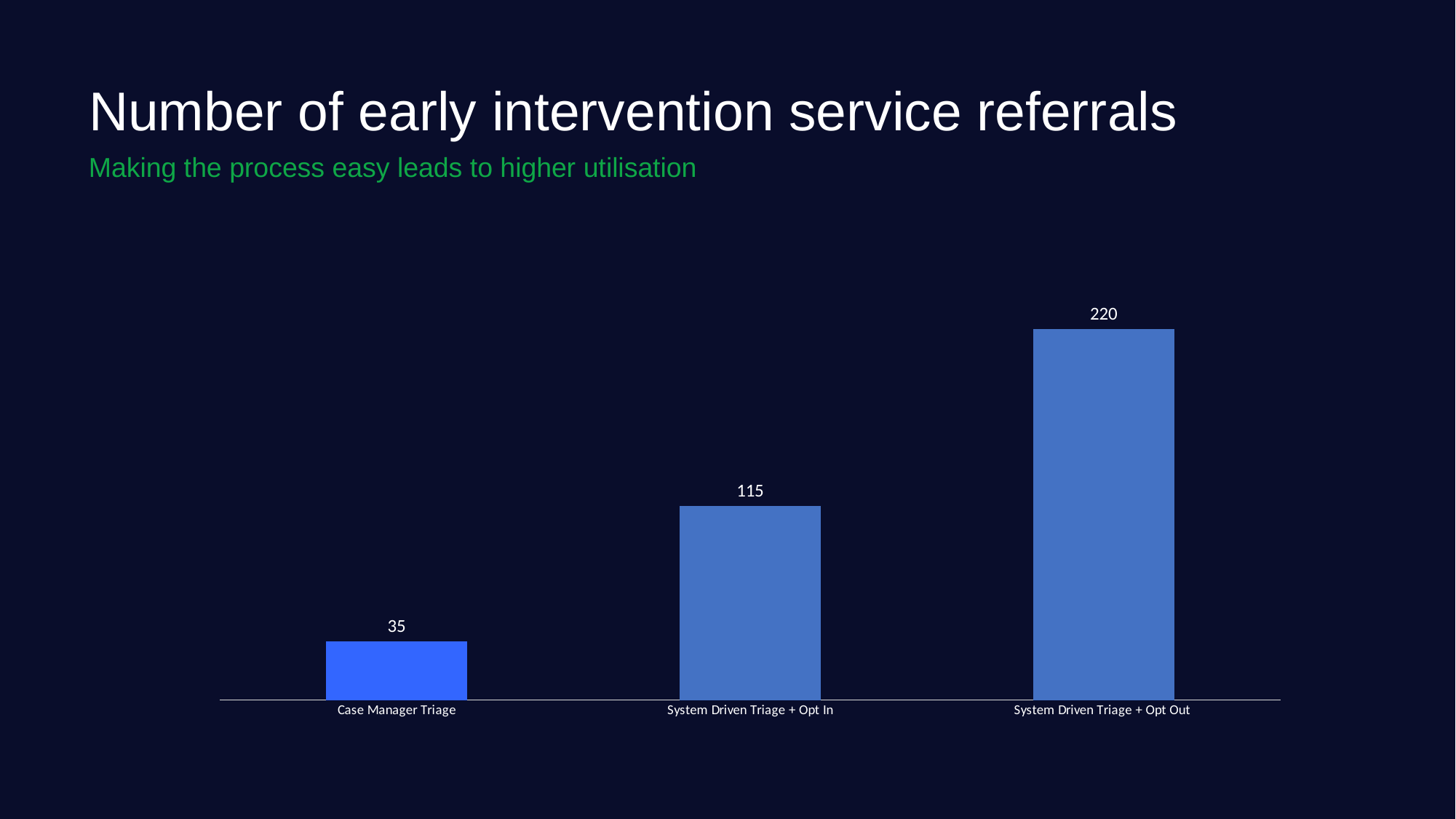
What is the difference in referrals between System Driven Triage + Opt Out and System Driven Triage + Opt In? 105 Which has more referrals, Case Manager Triage or System Driven Triage + Opt In? System Driven Triage + Opt In What kind of chart is shown on the slide? Bar chart Which category has the lowest number of referrals? Case Manager Triage What is the number of referrals for System Driven Triage + Opt In? 115 How many categories are shown in the chart? 3 What is the title of the chart on the slide? Number of early intervention service referrals What is the difference in referrals between System Driven Triage + Opt In and Case Manager Triage? 80 What is the number of early intervention service referrals for Case Manager Triage? 35 Which category has the highest number of referrals? System Driven Triage + Opt Out What is the number of referrals for System Driven Triage + Opt Out? 220 Do the values rise or fall from left to right across the categories? Rise